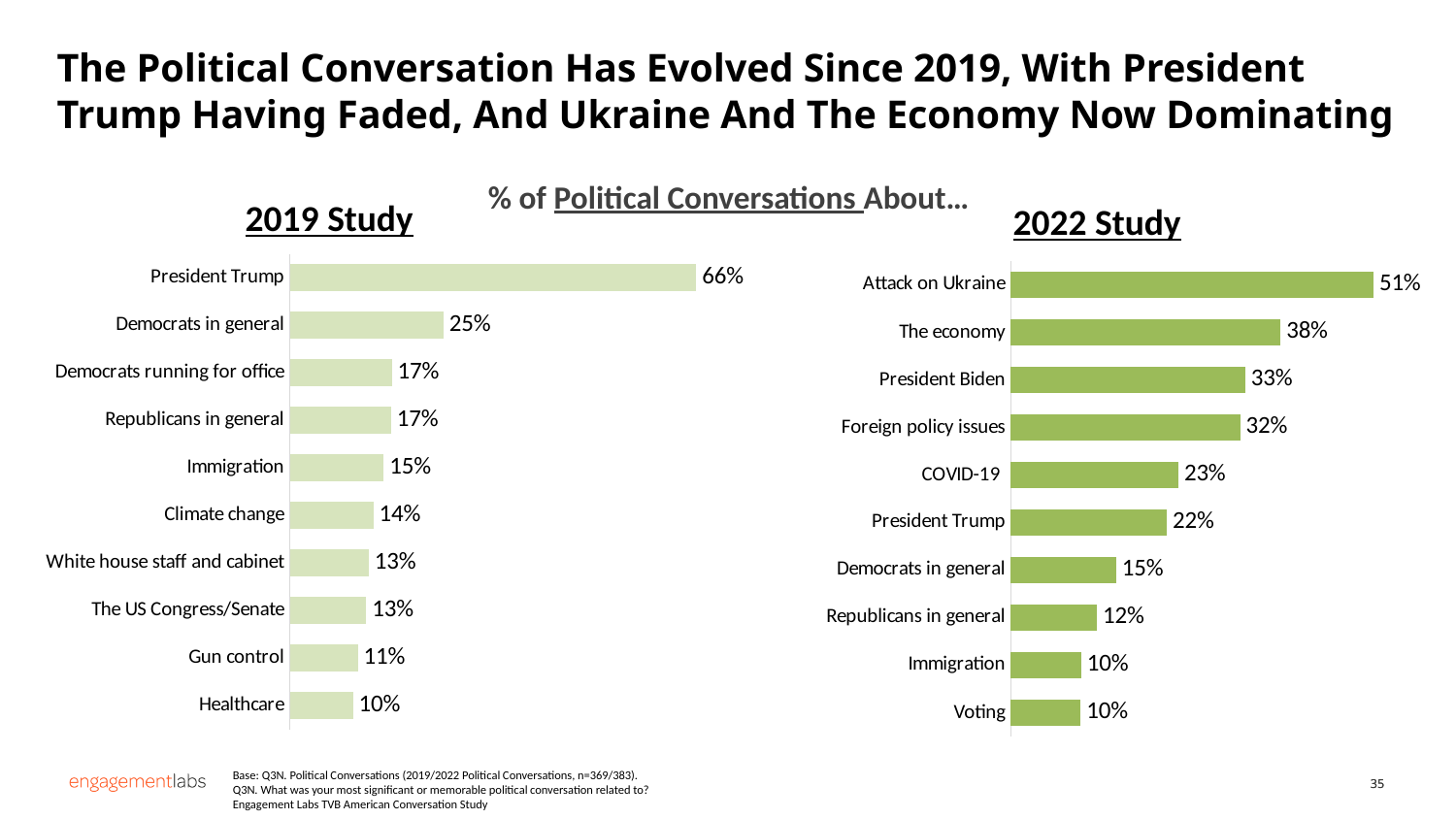
In the 2022 Study chart, what percentage of political conversations were about The economy? 38% In the 2019 Study chart, which category has the lowest value? Healthcare How many categories are shown in the 2019 Study chart? 10 In the 2019 Study chart, what percentage of political conversations were about President Trump? 66% In the 2022 Study chart, which category has the highest value? Attack on Ukraine What is the difference between the value for President Trump in the 2019 Study chart and the value for President Trump in the 2022 Study chart? 44% In the 2022 Study chart, what is the difference between the values for Attack on Ukraine and The economy? 13% In the 2022 Study chart, which is larger: the value for President Biden or the value for COVID-19? President Biden What is the shared title above the two charts? % of Political Conversations About… In the 2019 Study chart, what percentage of political conversations were about Immigration? 15% How many categories are shown in the 2022 Study chart? 10 What type of chart is the 2022 Study chart? Bar chart